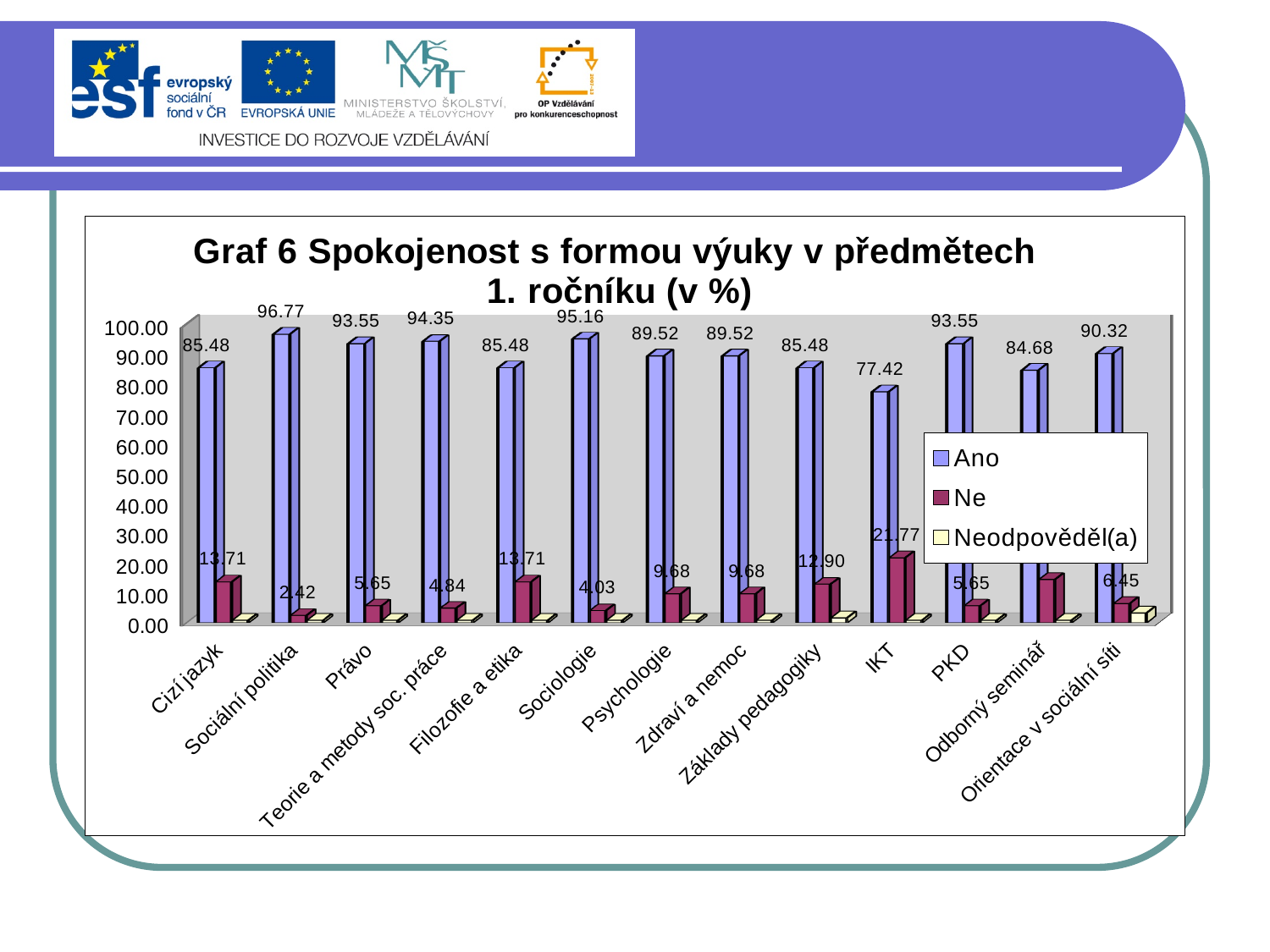
How many subjects are shown on the x axis? 13 Is the Neodpověděl(a) value for Cizí jazyk greater or less than 10.00? less What is the Ne value for IKT? 21.77 Which subject has the lowest Ano value? IKT What is the Ano value for Sociální politika? 96.77 Which subject has the highest Ne value? IKT Which has the larger Ano value, Právo or Teorie a metody soc. práce? Teorie a metody soc. práce How many series does the legend list? 3 What is the difference between the Ano value for Sociální politika and the Ano value for IKT? 19.35 What is the Ne value for Základy pedagogiky? 12.90 Which subject has the highest Ano value? Sociální politika What kind of chart is shown on the slide? bar chart